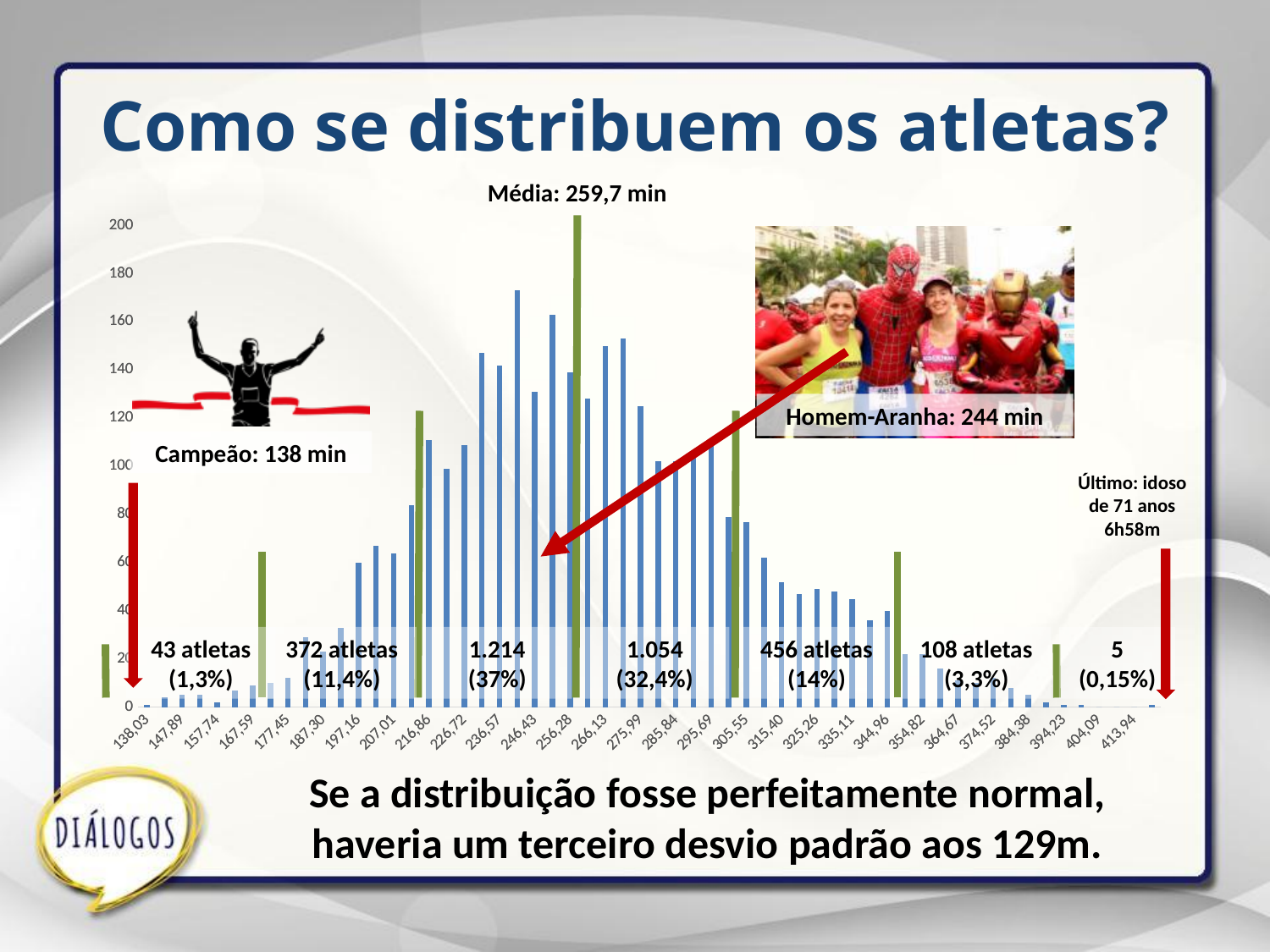
What finishing time is given for the last runner (Último)? 6h58m Which segment of the distribution has the largest number of athletes? 1.214 (37%) What is the mean (Média) finishing time shown on the chart? 259,7 min What kind of chart is shown on the slide? bar chart What is the difference between the 1.214 segment and the 1.054 segment? 160 What percentage of athletes is in the segment with 456 atletas? 14% What finishing time is given for Homem-Aranha? 244 min What is the champion's (Campeão) finishing time shown on the chart? 138 min How many athletes are in the segment labelled 37%? 1.214 Into how many labelled segments is the distribution divided along the bottom of the chart? 7 Which is larger, the segment with 372 atletas or the segment with 456 atletas? 456 atletas Which segment of the distribution has the smallest number of athletes? 5 (0,15%)